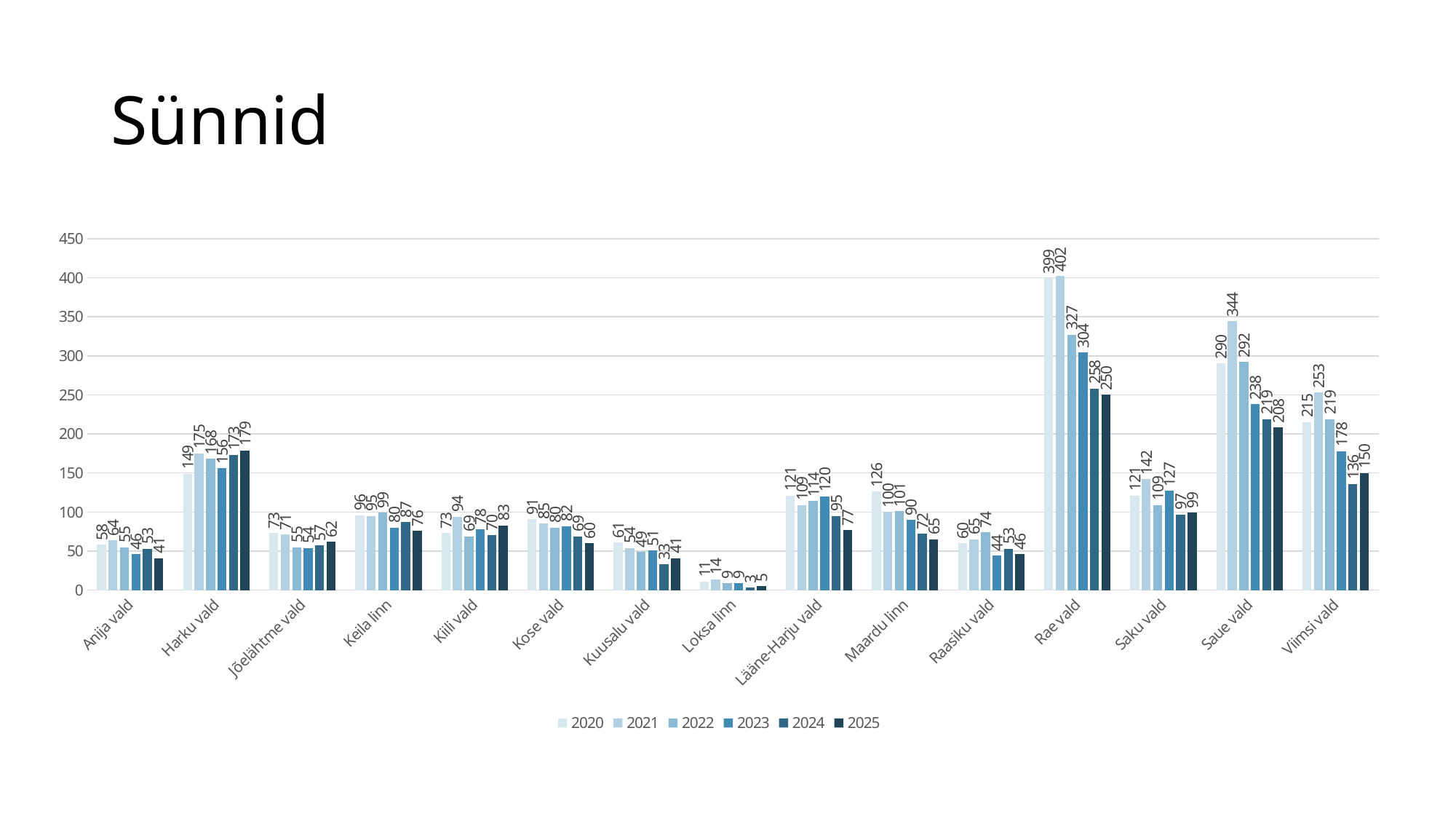
What is the value for Viimsi vald in 2024? 136 Which is larger: the 2023 value for Saku vald or the 2023 value for Lääne-Harju vald? Saku vald Is the value for Maardu linn in 2020 greater or less than 100? greater What is the value for Harku vald in 2025? 179 What is the value for Rae vald in 2021? 402 How many categories are shown on the x axis? 15 What is the difference between the 2021 and 2025 values for Saue vald? 136 Which category has the lowest value in 2025? Loksa linn What is the title of the chart? Sünnid Which category has the highest value in 2020? Rae vald What kind of chart is shown on the slide? bar chart How many series does the legend list? 6